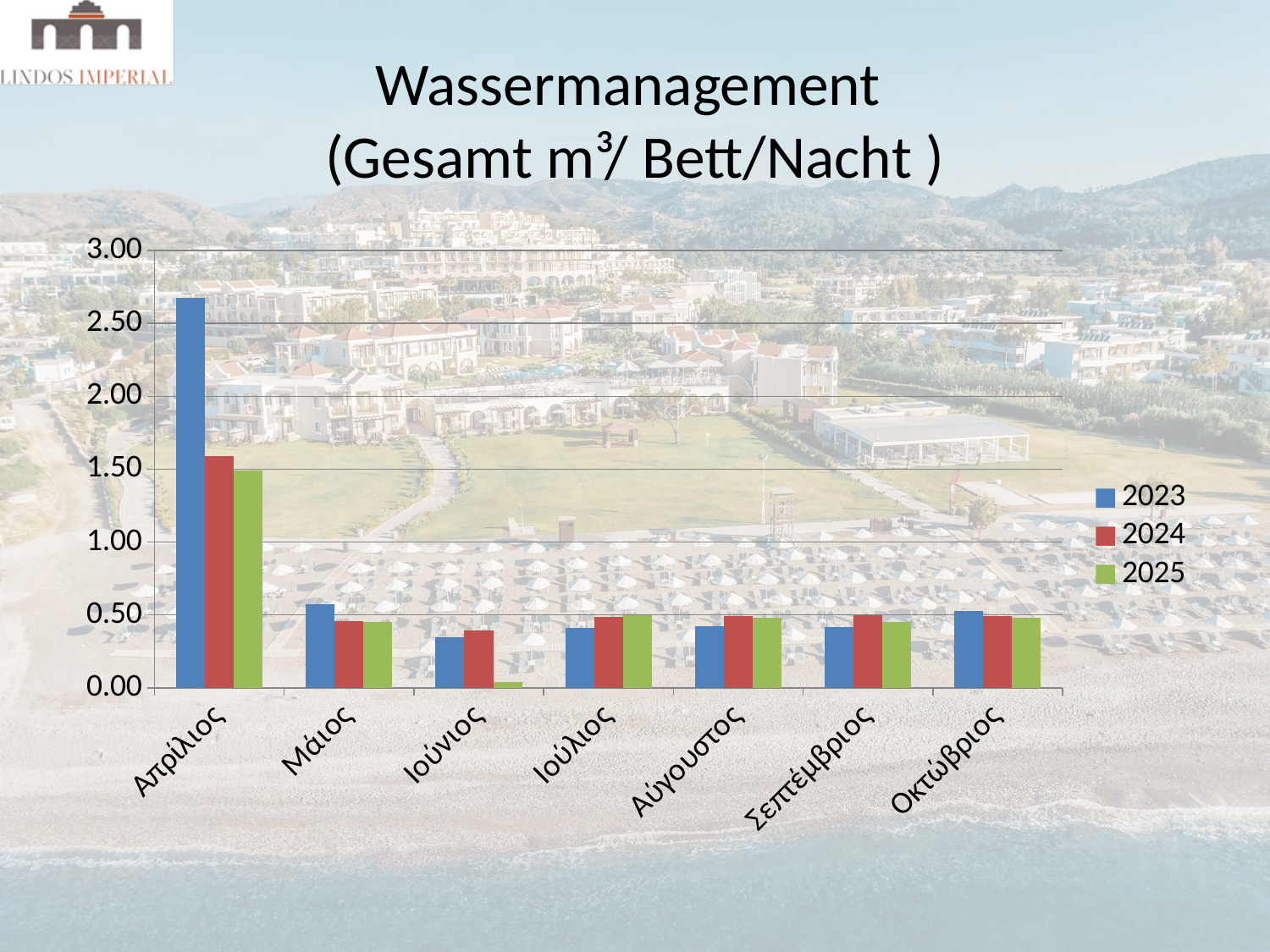
What is the title of the chart? Wassermanagement (Gesamt m³/ Bett/Nacht ) Is the 2023 value for Μάιος greater or less than 0.50? greater Is the 2025 value for Ιούνιος greater or less than 0.50? less How many months (categories) are shown on the x axis? 7 Is the 2023 value for Απρίλιος greater or less than 2.50? greater For Ιούνιος, which is larger: the 2023 value or the 2025 value? 2023 Which years are listed in the legend? 2023, 2024, 2025 In which month is the 2025 value lowest? Ιούνιος In which month is the 2023 value highest? Απρίλιος How many series does the legend list? 3 For Απρίλιος, which is larger: the 2023 value or the 2024 value? 2023 What kind of chart is shown on the slide? bar chart